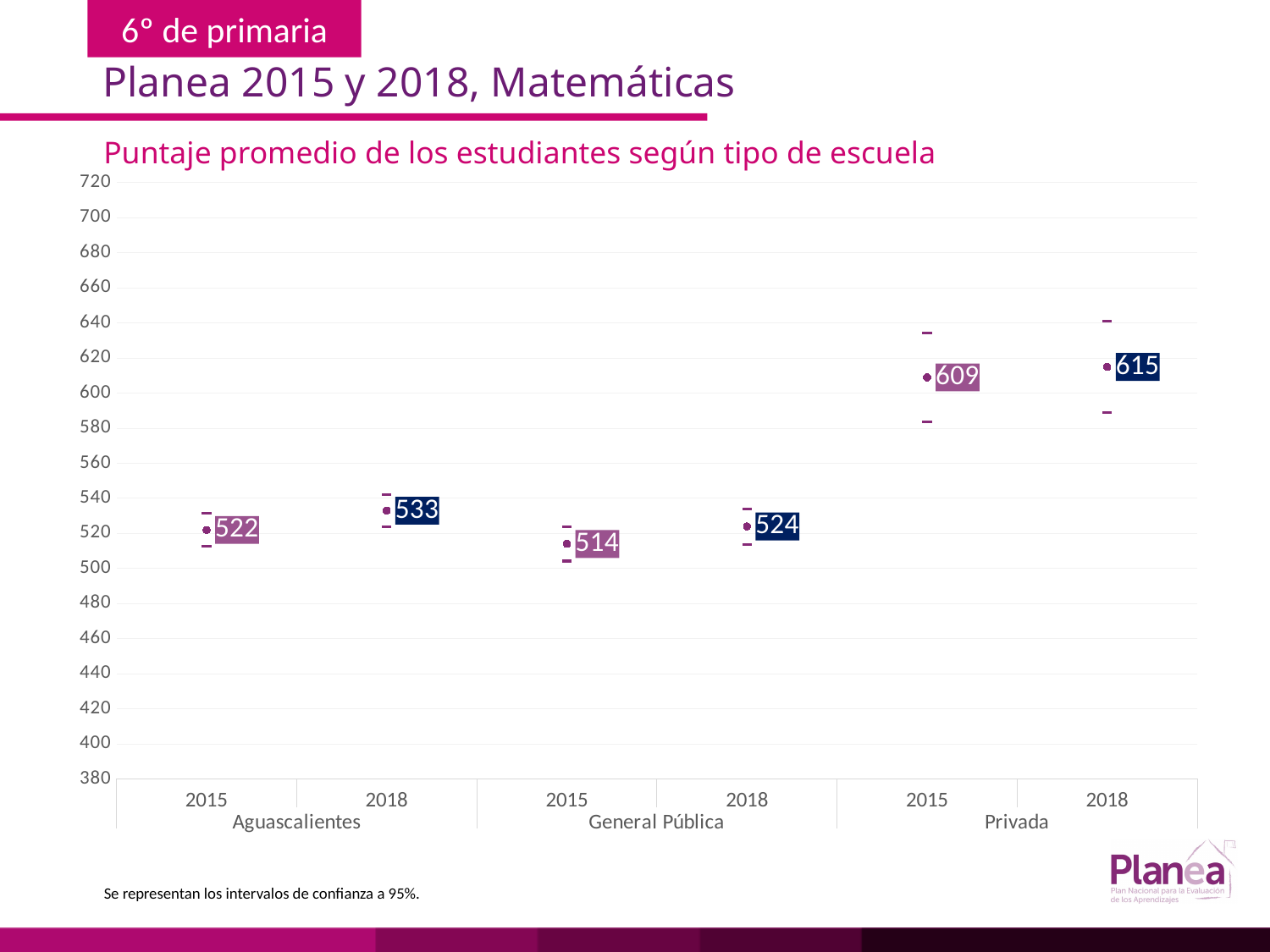
Which group and year has the highest average score? Privada 2018 What is the title of the chart? Puntaje promedio de los estudiantes según tipo de escuela What is the average score for Aguascalientes in 2015? 522 What is the average score for General Pública schools in 2015? 514 Which group and year has the lowest average score? General Pública 2015 Which is larger, the 2018 score for Aguascalientes or the 2018 score for General Pública? Aguascalientes 2018 How many data points are plotted on the chart? 6 By how many points did the Aguascalientes average score change from 2015 to 2018? 11 What is the average score for Aguascalientes in 2018? 533 Is the 2015 score for Privada schools greater or less than 600? greater What is the average score for Privada schools in 2018? 615 What is the difference between the Privada and General Pública average scores in 2018? 91